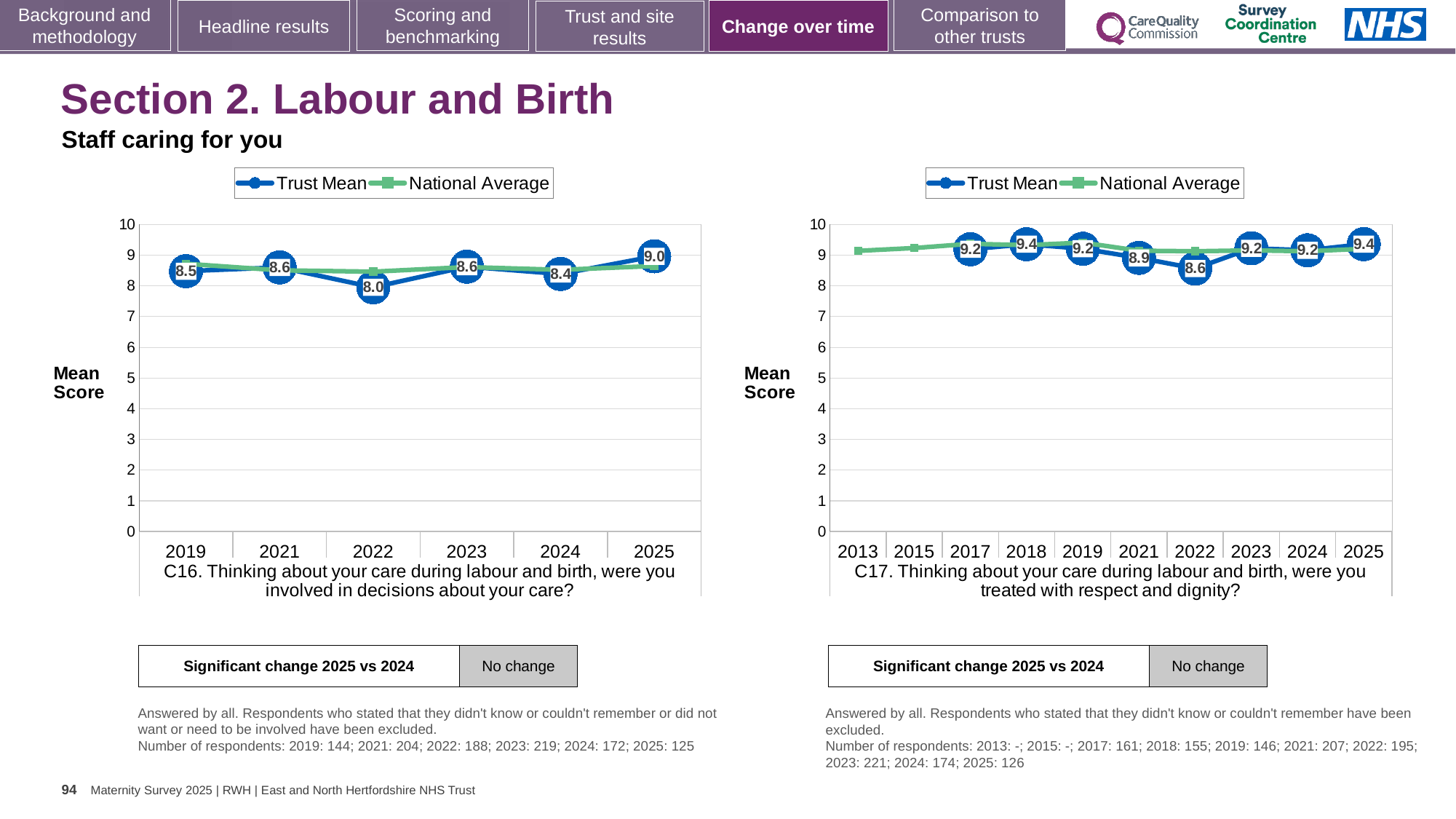
In the C17 chart, how many years are shown on the x axis? 10 In the C17 chart, what is the Trust Mean for 2022? 8.6 In the C16 chart, which year has the lowest Trust Mean? 2022 In the C16 chart, what is the Trust Mean for 2022? 8.0 In the C17 chart, is the Trust Mean for 2021 or 2023 higher? 2023 In the C17 chart, which year has the lowest Trust Mean? 2022 How many series does the legend of the C16 chart list? 2 In the C16 chart, is the Trust Mean for 2019 greater or less than 8? greater In the C16 chart, which year has the highest Trust Mean? 2025 In the C16 chart, what is the difference between the Trust Mean for 2025 and 2024? 0.6 What type of chart is the C17 chart? Line chart In the C16 chart, what is the Trust Mean for 2025? 9.0